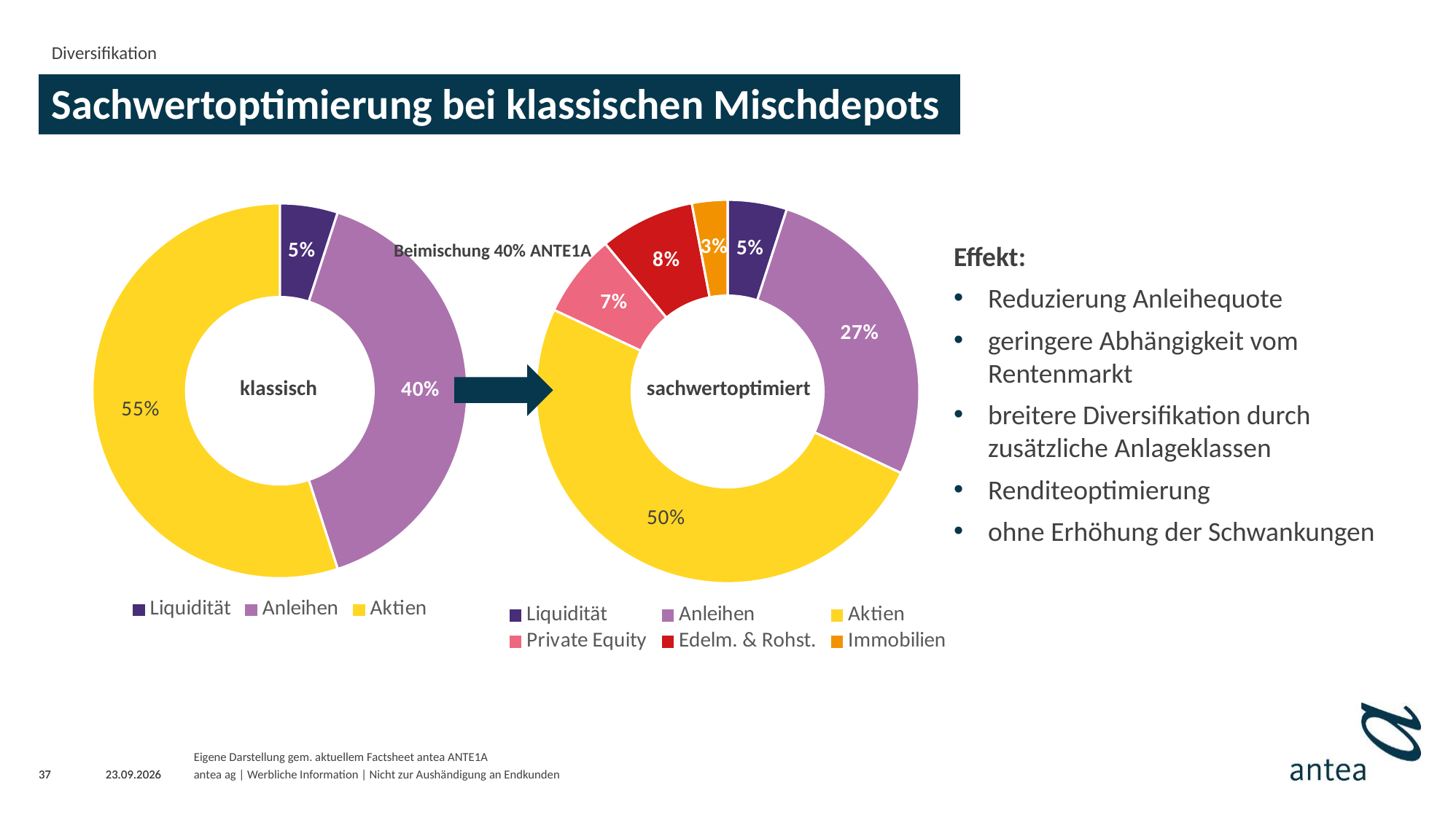
How many categories does the 'sachwertoptimiert' chart show? 6 What is the difference between the Anleihen share in the 'klassisch' chart and the Anleihen share in the 'sachwertoptimiert' chart? 13% In the 'klassisch' chart, what share does Anleihen have? 40% In the 'sachwertoptimiert' chart, which is larger: Private Equity or Edelm. & Rohst.? Edelm. & Rohst. In the 'klassisch' chart, which category has the smallest share? Liquidität In the 'sachwertoptimiert' chart, which category has the largest share? Aktien In the 'sachwertoptimiert' chart, which category has the smallest share? Immobilien In the 'sachwertoptimiert' chart, what share does Immobilien have? 3% In the 'sachwertoptimiert' chart, what share does Edelm. & Rohst. have? 8% What kind of chart is the 'klassisch' chart? Doughnut chart In the 'sachwertoptimiert' chart, what share does Anleihen have? 27% In the 'klassisch' chart, what share does Aktien have? 55%